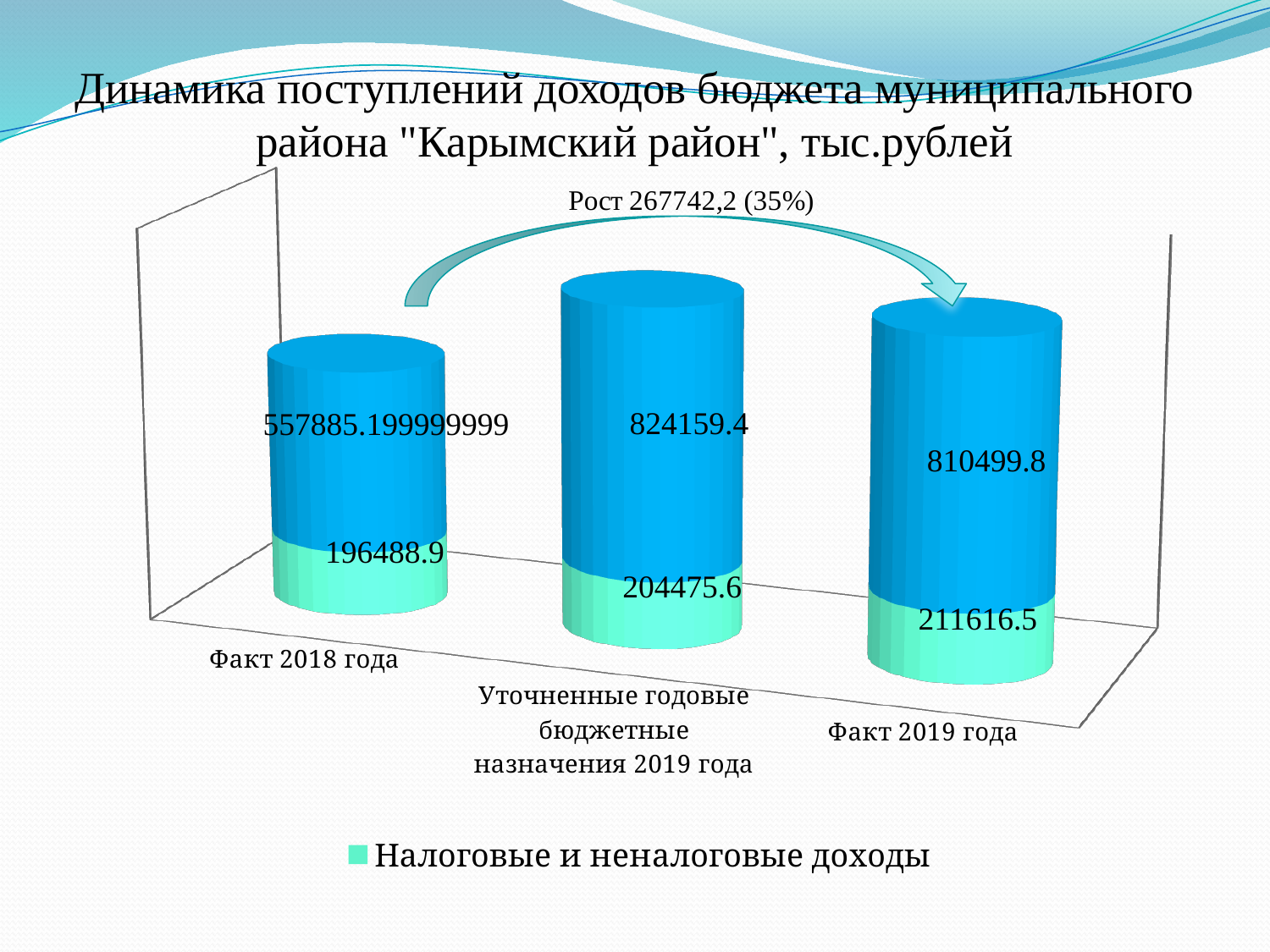
What is the value of the upper blue segment for 'Факт 2019 года'? 810499.8 What growth annotation is written above the bars? Рост 267742,2 (35%) What kind of chart is shown on the slide? Stacked bar chart What is the value of the 'Налоговые и неналоговые доходы' segment for 'Уточненные годовые бюджетные назначения 2019 года'? 204475.6 How many categories are shown on the x axis? 3 By how much does the 'Налоговые и неналоговые доходы' value for 'Факт 2019 года' exceed that for 'Факт 2018 года'? 15127.6 Which has the larger upper blue segment: 'Уточненные годовые бюджетные назначения 2019 года' or 'Факт 2019 года'? Уточненные годовые бюджетные назначения 2019 года How many series does the legend list? 1 What is the value of the 'Налоговые и неналоговые доходы' segment for 'Факт 2018 года'? 196488.9 What is the total of the stacked bar for 'Факт 2019 года'? 1022116.3 Which category has the highest value for 'Налоговые и неналоговые доходы'? Факт 2019 года Which category has the lowest value for the upper blue segment? Факт 2018 года